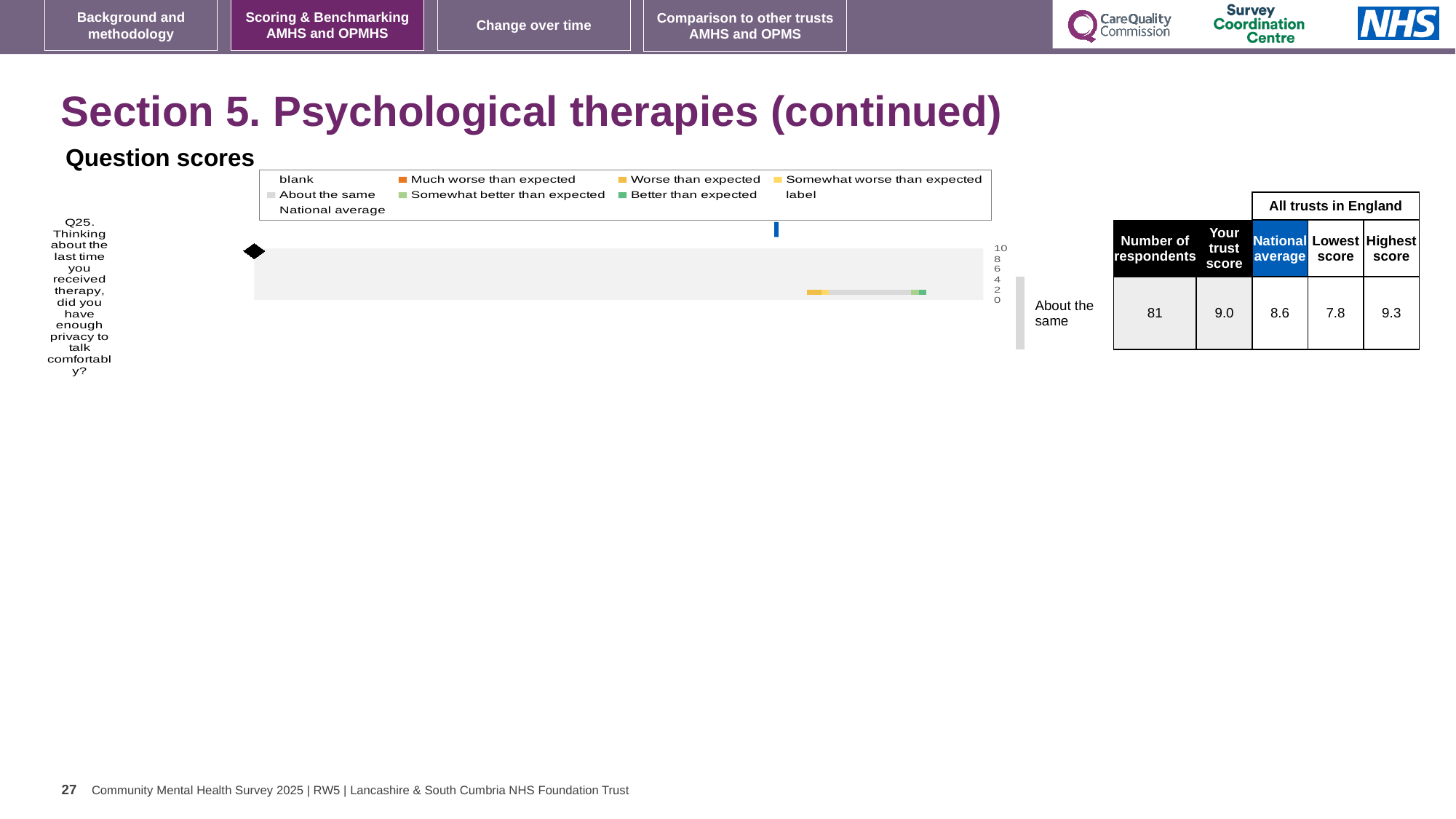
What is the highest score among all trusts in England for Q25? 9.3 How many respondents answered Q25 according to the table beside the chart? 81 What is the trust's score for Q25 shown in the table beside the chart? 9.0 Which is larger for Q25, the trust score or the national average? the trust score What is the national average for Q25 shown in the table beside the chart? 8.6 What is the highest tick value shown on the chart's score axis? 10 What kind of chart is shown under 'Question scores'? bar chart What is the lowest score among all trusts in England for Q25? 7.8 Which question is plotted in the chart? Q25. Thinking about the last time you received therapy, did you have enough privacy to talk comfortably? What is the difference between the trust score and the national average for Q25? 0.4 What benchmark category label is shown next to the bar for Q25? About the same How many survey questions are plotted in the chart? 1